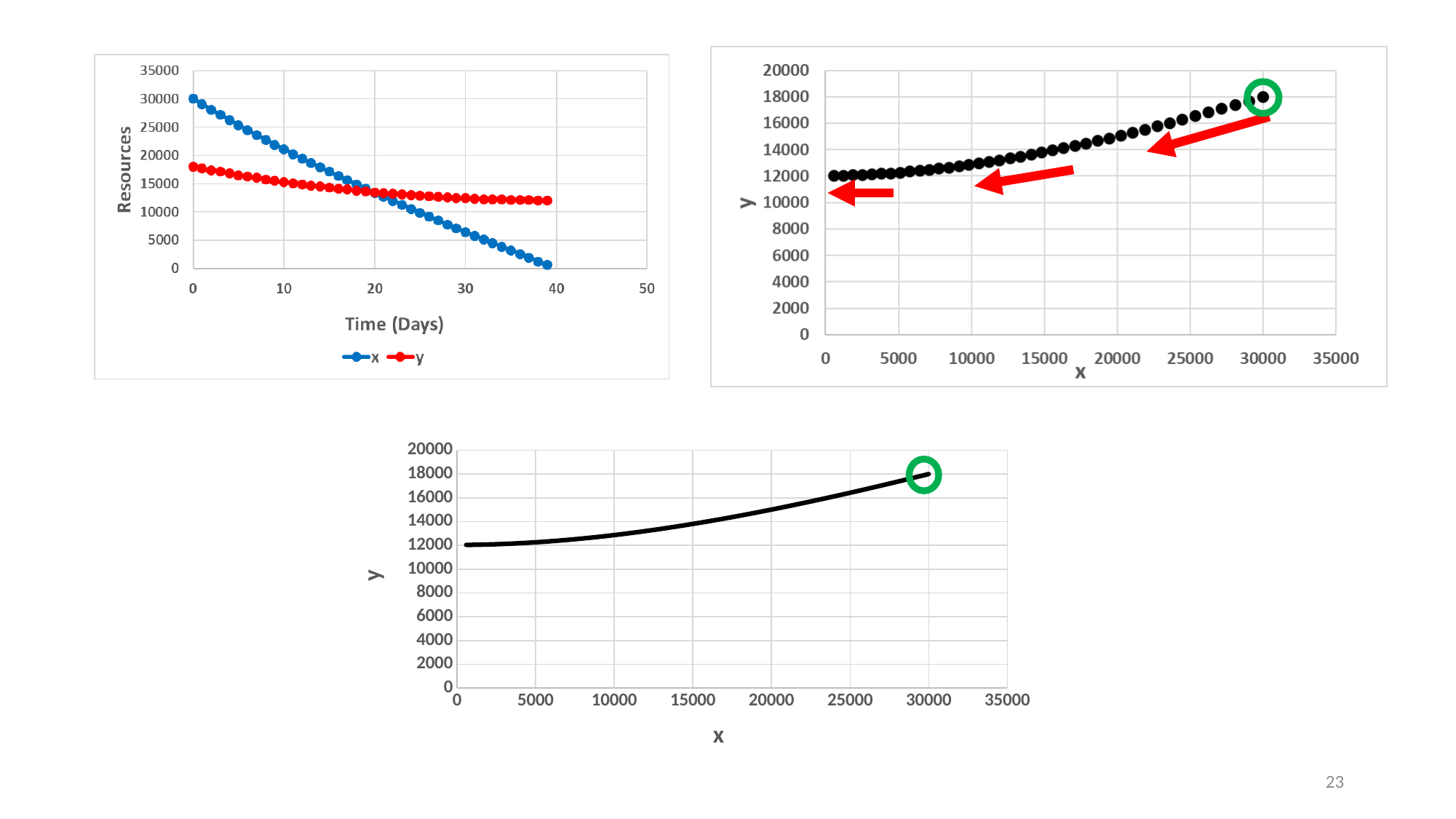
In the top-left chart, is the value of the x series at day 10 greater or less than 20000? greater In the top-right chart, what is the y value of the circled point at x = 30000? 18000 In the top-right chart, does y rise or fall as x increases? Rises In the top-left chart, what is the value of the x series at day 0? 30000 In the top-left chart, what is the x-axis title? Time (Days) In the top-left chart, what are the two legend entries? x and y In the top-left chart, which series has the higher value at day 0, x or y? x What kind of chart is the bottom chart? Line chart In the top-left chart, which series has the higher value at day 30, x or y? y In the bottom chart, is the y value at x = 10000 greater or less than 14000? less In the top-left chart, how many series does the legend list? 2 In the top-left chart, does the x series rise or fall as time increases? Falls